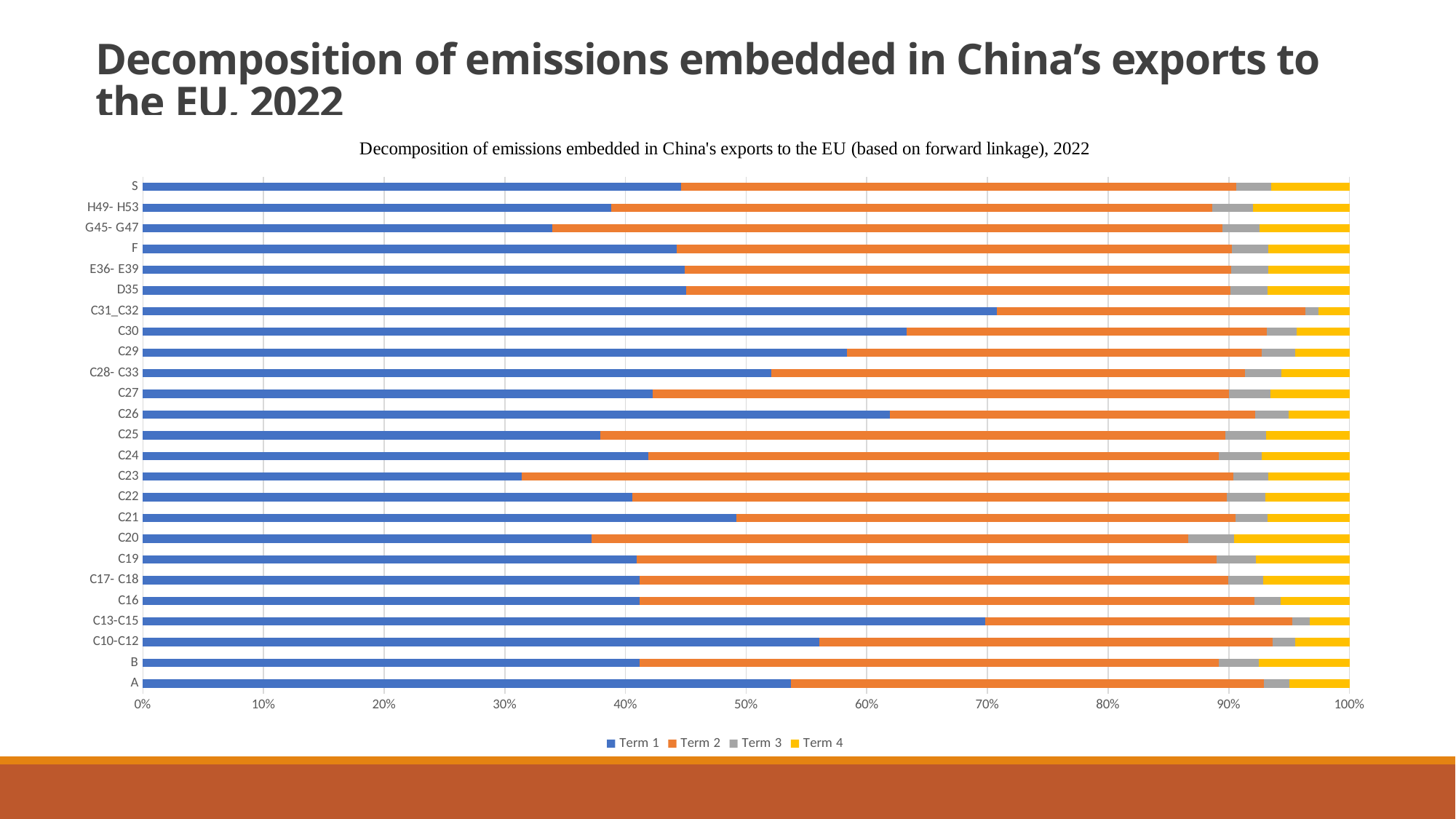
What is the title of the chart? Decomposition of emissions embedded in China's exports to the EU (based on forward linkage), 2022 Is the Term 1 value for G45- G47 greater or less than 40%? less Which has the larger Term 1 share, C30 or C25? C30 What kind of chart is shown on the slide? Stacked bar chart Is the Term 1 value for C31_C32 greater or less than 60%? greater How many series does the legend list? 4 Is the Term 1 value for A greater or less than 50%? greater Which has the larger Term 1 share, C20 or C21? C21 What does each stacked bar total on the horizontal axis? 100% What are the four legend entries of the chart? Term 1, Term 2, Term 3, Term 4 How many categories are plotted on the vertical axis? 25